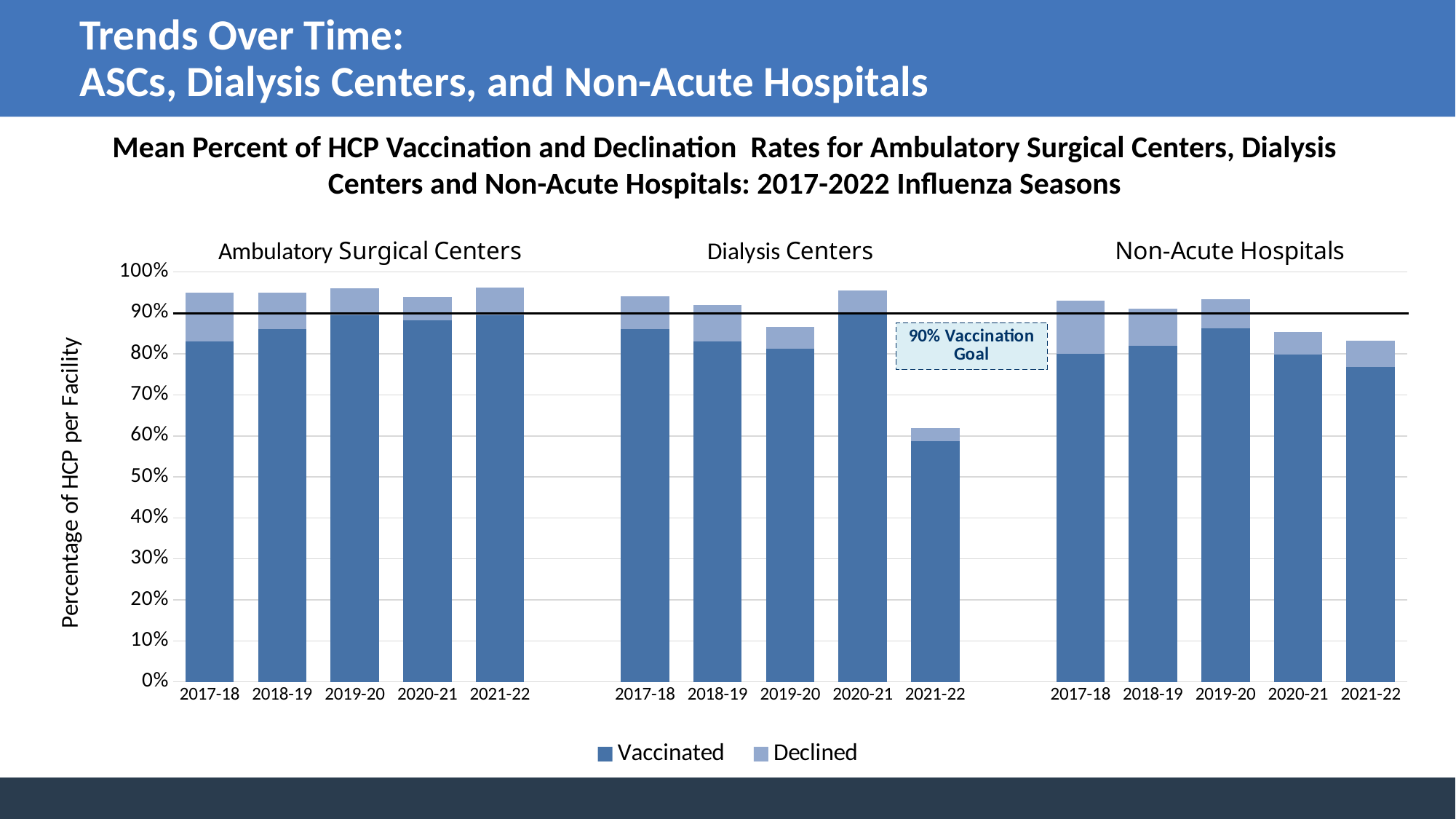
What are the two legend entries in the chart? Vaccinated and Declined What kind of chart is shown on the slide? bar chart How many influenza seasons are shown for Dialysis Centers? 5 Is the Vaccinated value for Dialysis Centers in 2020-21 greater or less than 80%? greater How many series does the legend list? 2 Is the Vaccinated value for Non-Acute Hospitals in 2021-22 greater or less than 80%? less What does the horizontal line across the chart represent? 90% Vaccination Goal Which season has the lowest Vaccinated value for Dialysis Centers? 2021-22 For Ambulatory Surgical Centers, which is larger: the Vaccinated value in 2019-20 or in 2017-18? 2019-20 How many facility types are shown in the chart? 3 For Non-Acute Hospitals, do the Vaccinated values rise or fall from 2019-20 to 2021-22? fall Is the Vaccinated value for Dialysis Centers in 2021-22 greater or less than 70%? less